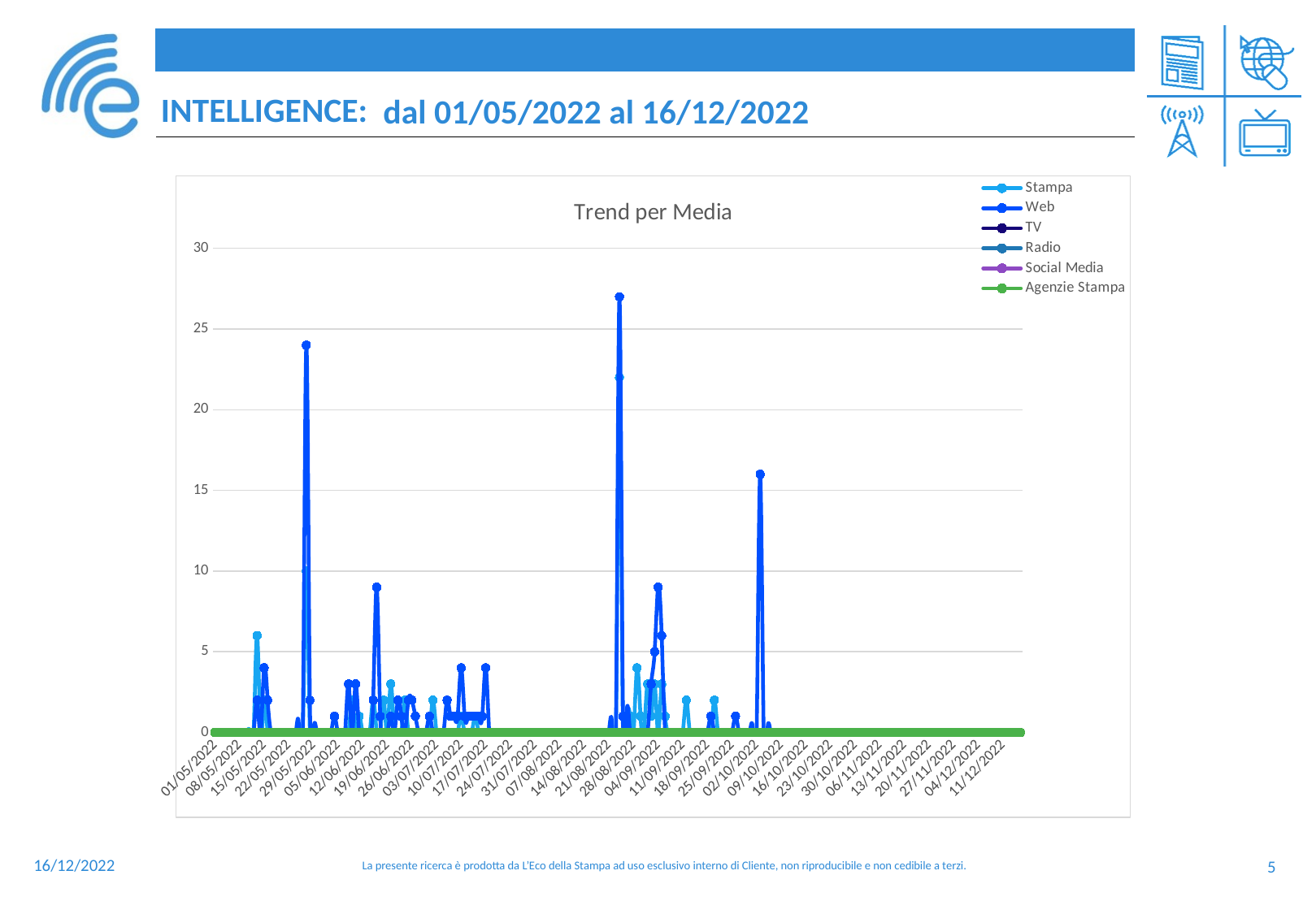
What kind of chart is shown on the slide? line chart What is the highest value shown on the y axis? 30 What is the title of the chart? Trend per Media Is the Web peak near 02/10/2022 greater or less than 20? less Do the Web values rise or fall after the peak near 02/10/2022 through to 11/12/2022? fall Is the Web peak near 19/06/2022 greater or less than 10? less Is the highest Web peak, near 28/08/2022, greater or less than 25? greater How many date labels are shown on the x axis? 33 How many series does the legend list? 6 Which series reaches the highest value on the chart? Web Which is larger: the Web peak near 28/08/2022 or the Web peak near 22/05/2022? the Web peak near 28/08/2022